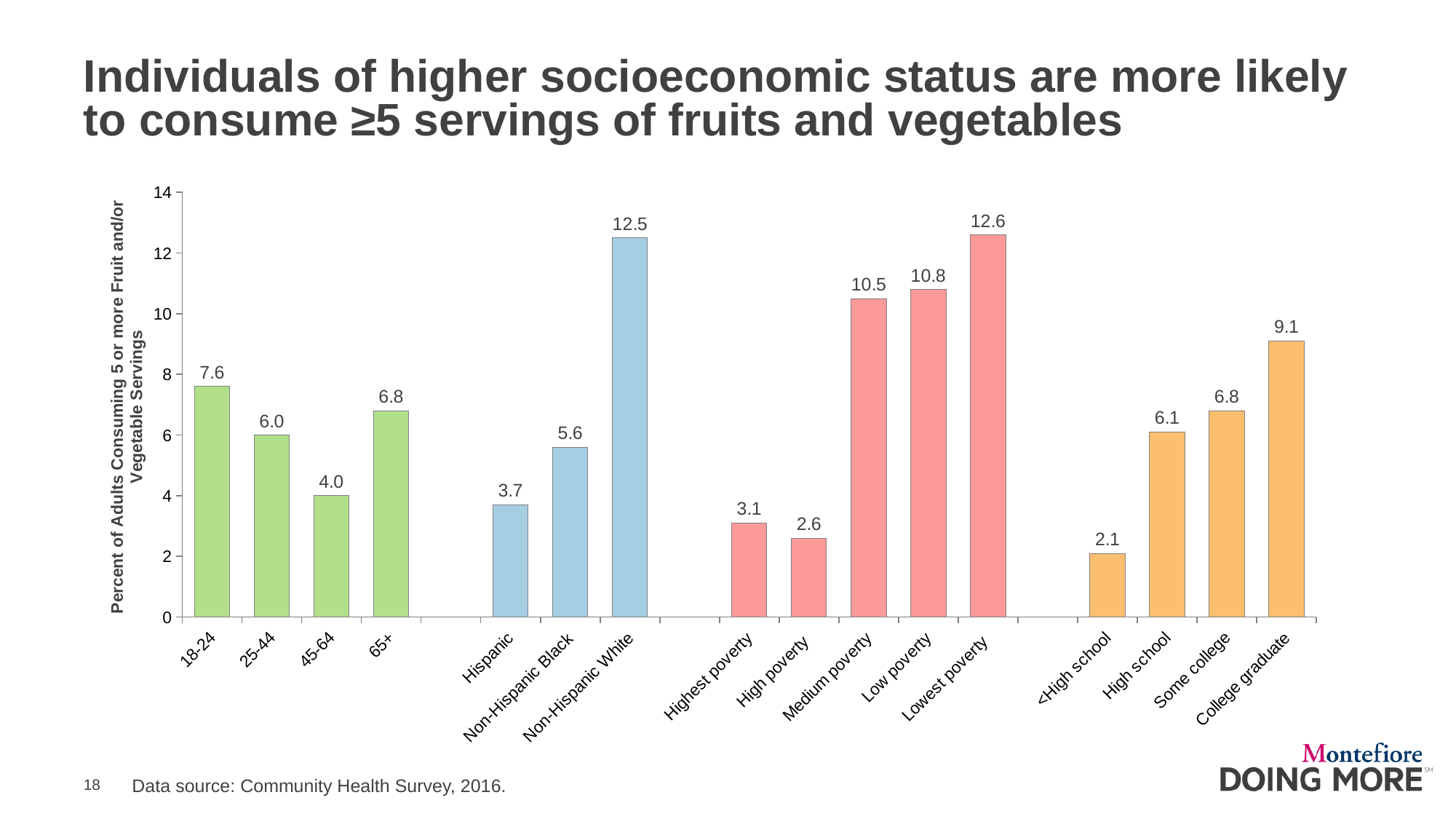
What is the data source cited on the slide? Community Health Survey, 2016 What is the value for Non-Hispanic White? 12.5 What kind of chart is shown on the slide? Bar chart What is the value for College graduate? 9.1 Which is larger, the value for Hispanic or the value for Non-Hispanic Black? Non-Hispanic Black What is the difference between the values for Lowest poverty and Highest poverty? 9.5 What is the value for the 45-64 age group? 4.0 What is the difference between the values for High school and <High school? 4.0 Which category has the highest value on the chart? Lowest poverty Which category has the lowest value on the chart? <High school How many categories are plotted on the chart? 16 Do the values rise or fall across the education categories from <High school to College graduate? Rise